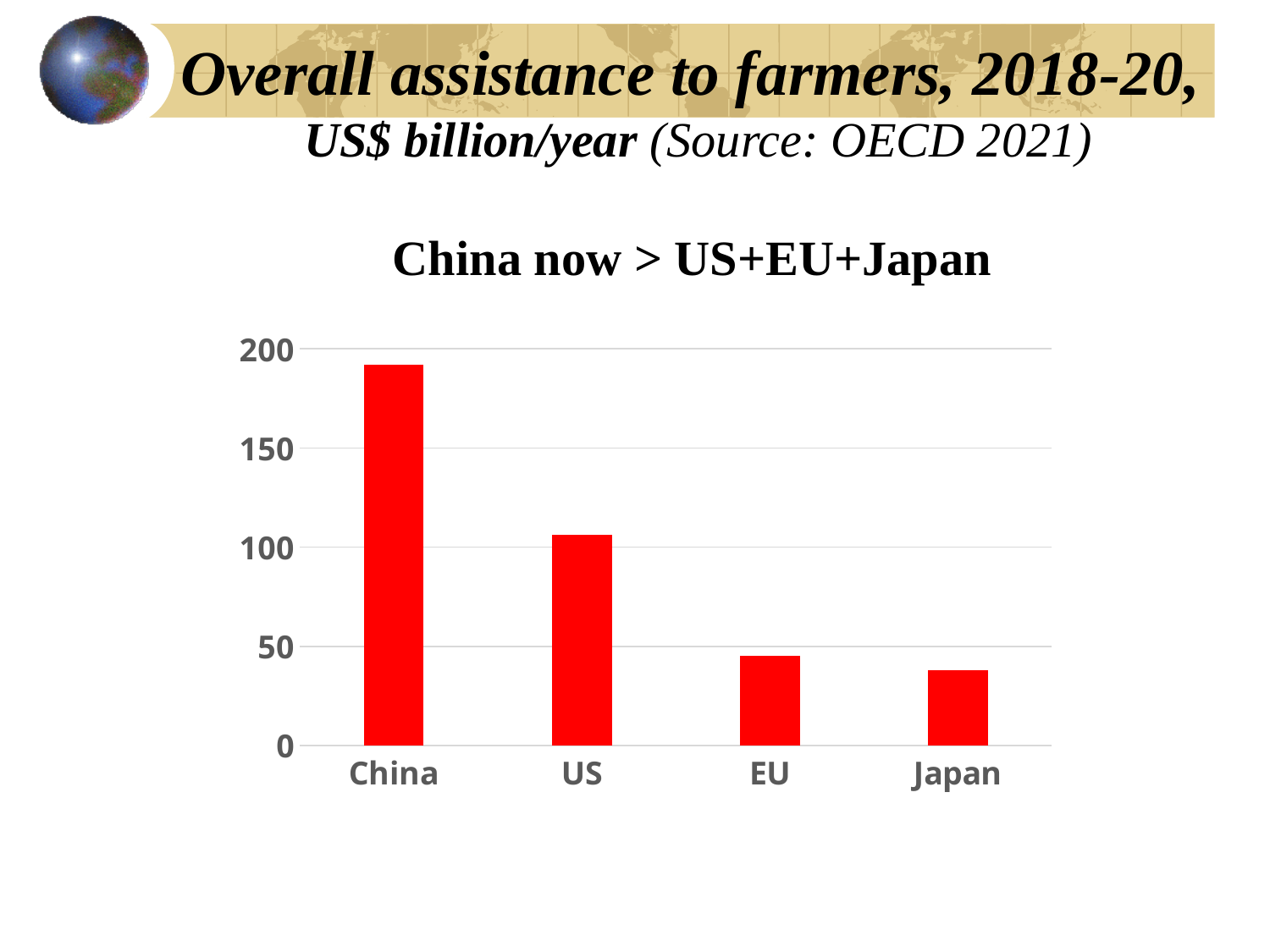
Is the value for US greater or less than 50? greater Is the value for EU greater or less than 100? less Which is larger, the value for China or the value for US? China Is the value for Japan greater or less than 50? less Which category has the lowest value on the chart? Japan What kind of chart is shown on the slide? bar chart What is the heading shown directly above the chart? China now > US+EU+Japan Do the values rise or fall moving from left to right along the x axis? fall How many categories are plotted on the chart? 4 Which category has the highest value on the chart? China